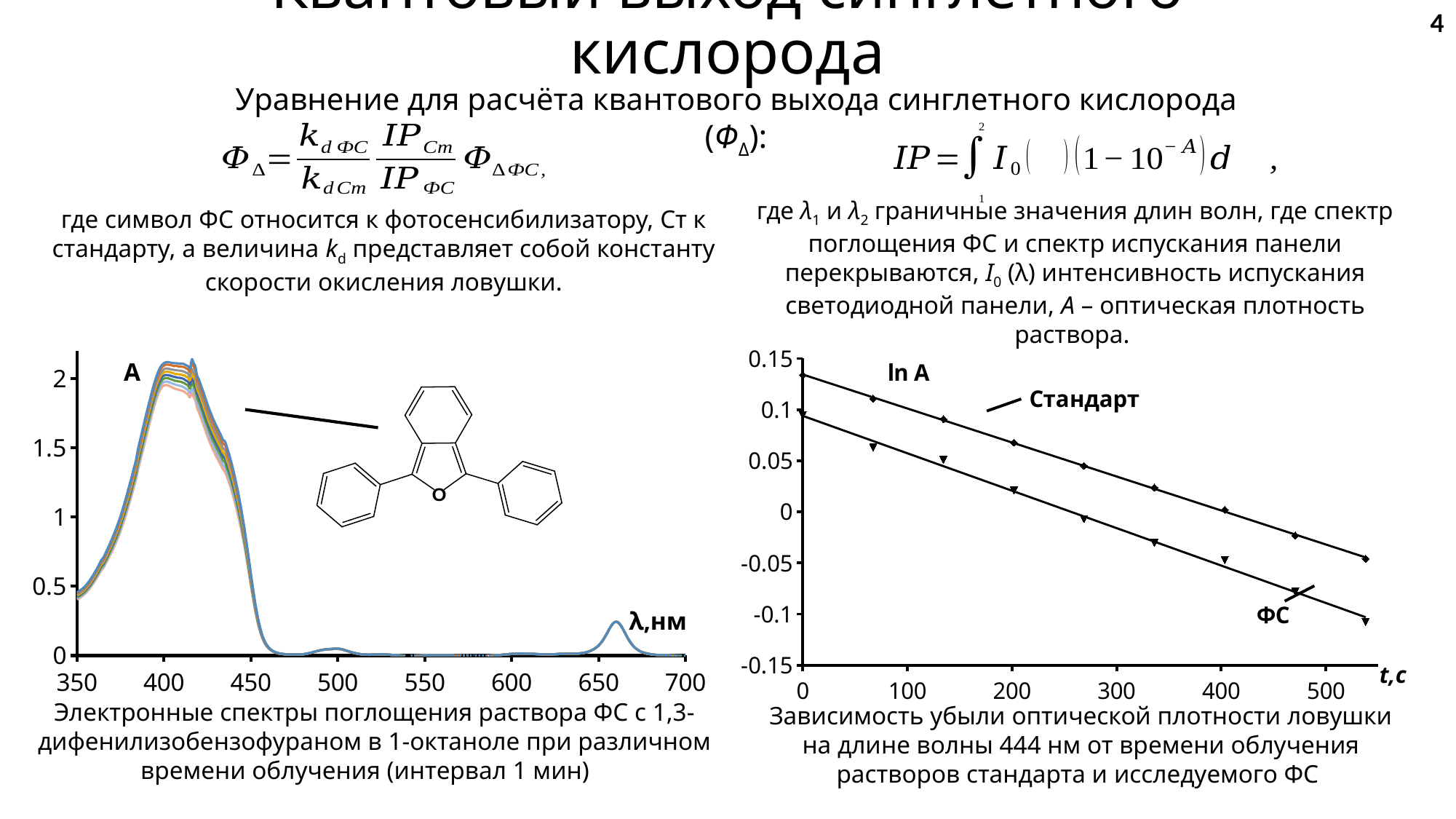
What kind of chart is the left chart (electronic absorption spectra)? line chart On the left chart (absorption spectra), is the absorbance at 400 nm greater or less than 1.5? greater On the right chart (ln A vs t), is the ln A value for Стандарт at t = 0 greater or less than 0.1? greater On the right chart (ln A vs t), do the values rise or fall as t increases? fall On the right chart (ln A vs t), is the ln A value for Стандарт at about t = 540 greater or less than 0? less On the right chart (ln A vs t), how many series are shown? 2 On the right chart (ln A vs t), which series has the higher ln A at t = 0, Стандарт or ФС? Стандарт On the left chart (absorption spectra), what is the label of the x axis? λ,нм On the right chart (ln A vs t), what is the label of the x axis? t,c